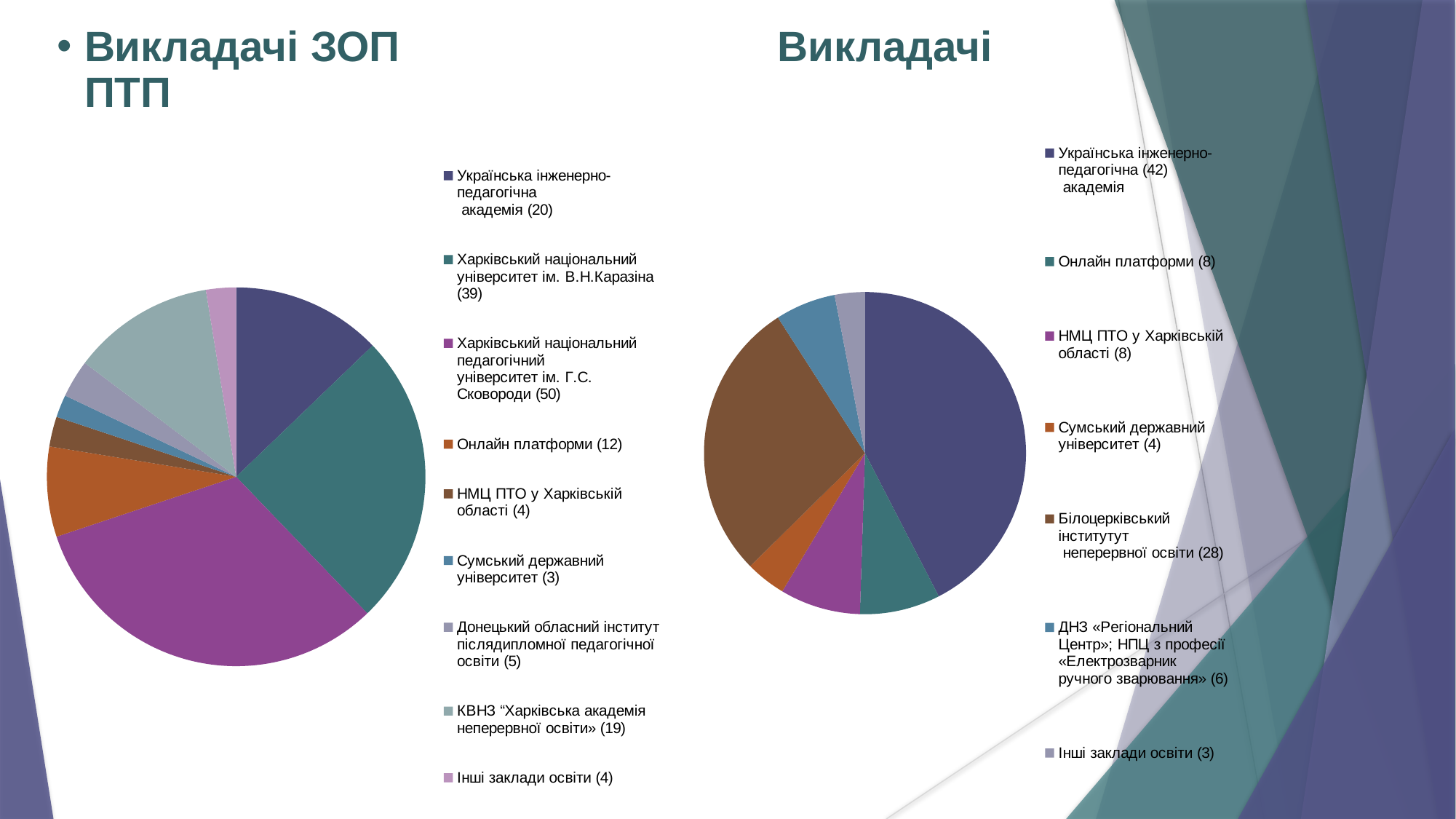
In the right chart "Викладачі", which category has the largest value? Українська інженерно-педагогічна академія In the right chart "Викладачі", which is larger: Сумський державний університет or ДНЗ «Регіональний Центр»; НПЦ з професії «Електрозварник ручного зварювання»? ДНЗ «Регіональний Центр»; НПЦ з професії «Електрозварник ручного зварювання» In the right chart "Викладачі", what is the difference between Українська інженерно-педагогічна академія and Білоцерківський інститут неперервної освіти? 14 What type of chart is used on the left chart titled "Викладачі ЗОП ПТП"? pie chart In the left chart "Викладачі ЗОП ПТП", which category has the smallest value? Сумський державний університет In the left chart "Викладачі ЗОП ПТП", which category has the largest value? Харківський національний педагогічний університет ім. Г.С. Сковороди In the left chart "Викладачі ЗОП ПТП", what is the value for Онлайн платформи? 12 In the right chart "Викладачі", what is the value for Білоцерківський інститут неперервної освіти? 28 How many categories does the legend of the right chart "Викладачі" list? 7 In the left chart "Викладачі ЗОП ПТП", what is the difference between Харківський національний університет ім. В.Н.Каразіна and Українська інженерно-педагогічна академія? 19 In the left chart "Викладачі ЗОП ПТП", what is the value for Харківський національний педагогічний університет ім. Г.С. Сковороди? 50 How many categories does the legend of the left chart "Викладачі ЗОП ПТП" list? 9